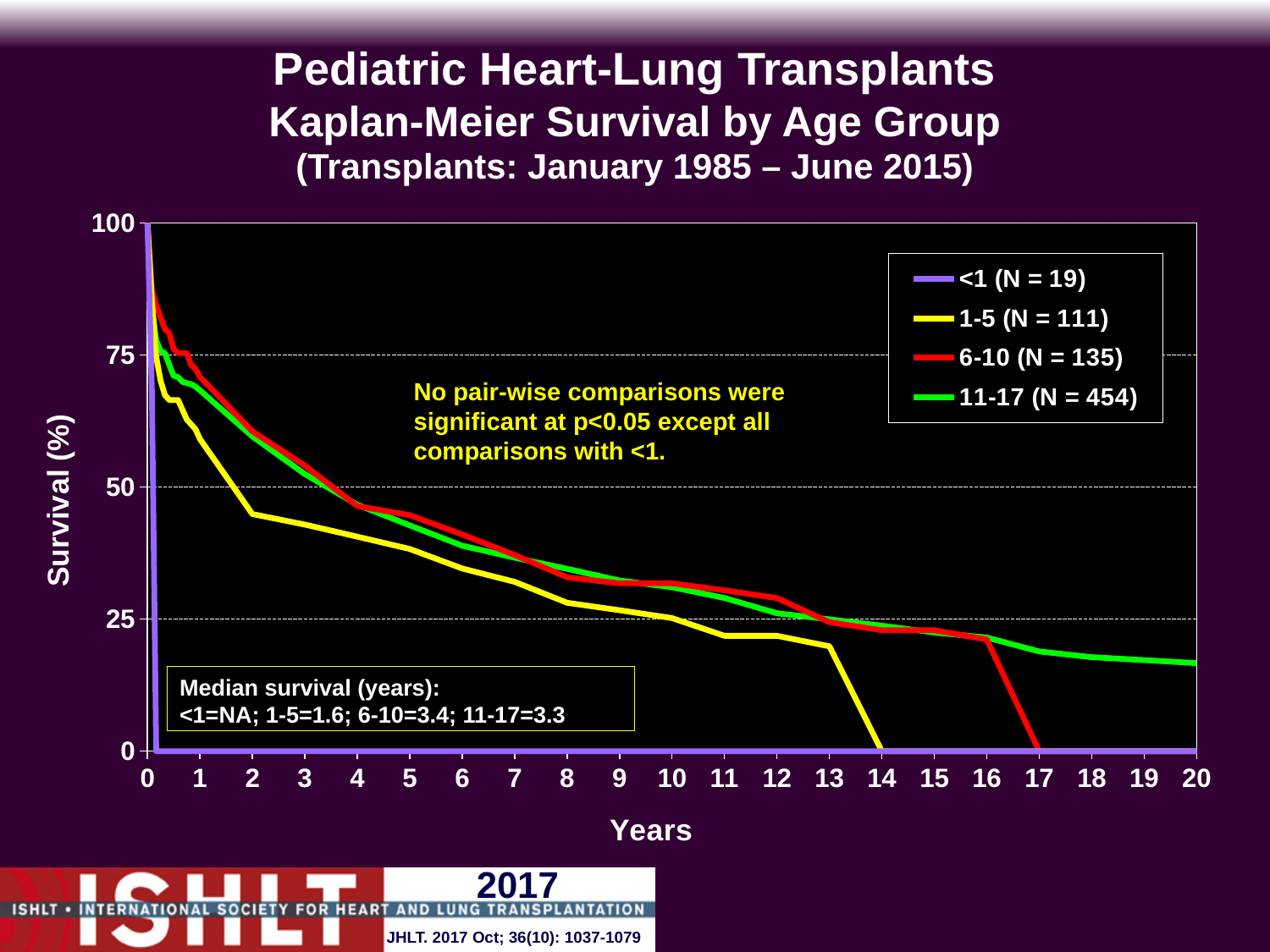
What is the N for the 11-17 age group in the legend? 454 Which age group has the largest N in the legend? 11-17 Which age group has the smallest N in the legend? <1 Is the survival for the 6-10 group at 1 year greater or less than 50? greater How many age groups does the legend list? 4 What kind of chart is shown on the slide? line chart What is the median survival in years for the 1-5 age group? 1.6 At 2 years, which group has higher survival, 6-10 or 1-5? 6-10 Do the survival curves rise or fall as years increase? fall What is the median survival in years for the 6-10 age group? 3.4 Is the survival for the 11-17 group at 20 years greater or less than 25? less What is the difference in N between the 11-17 group and the 6-10 group? 319